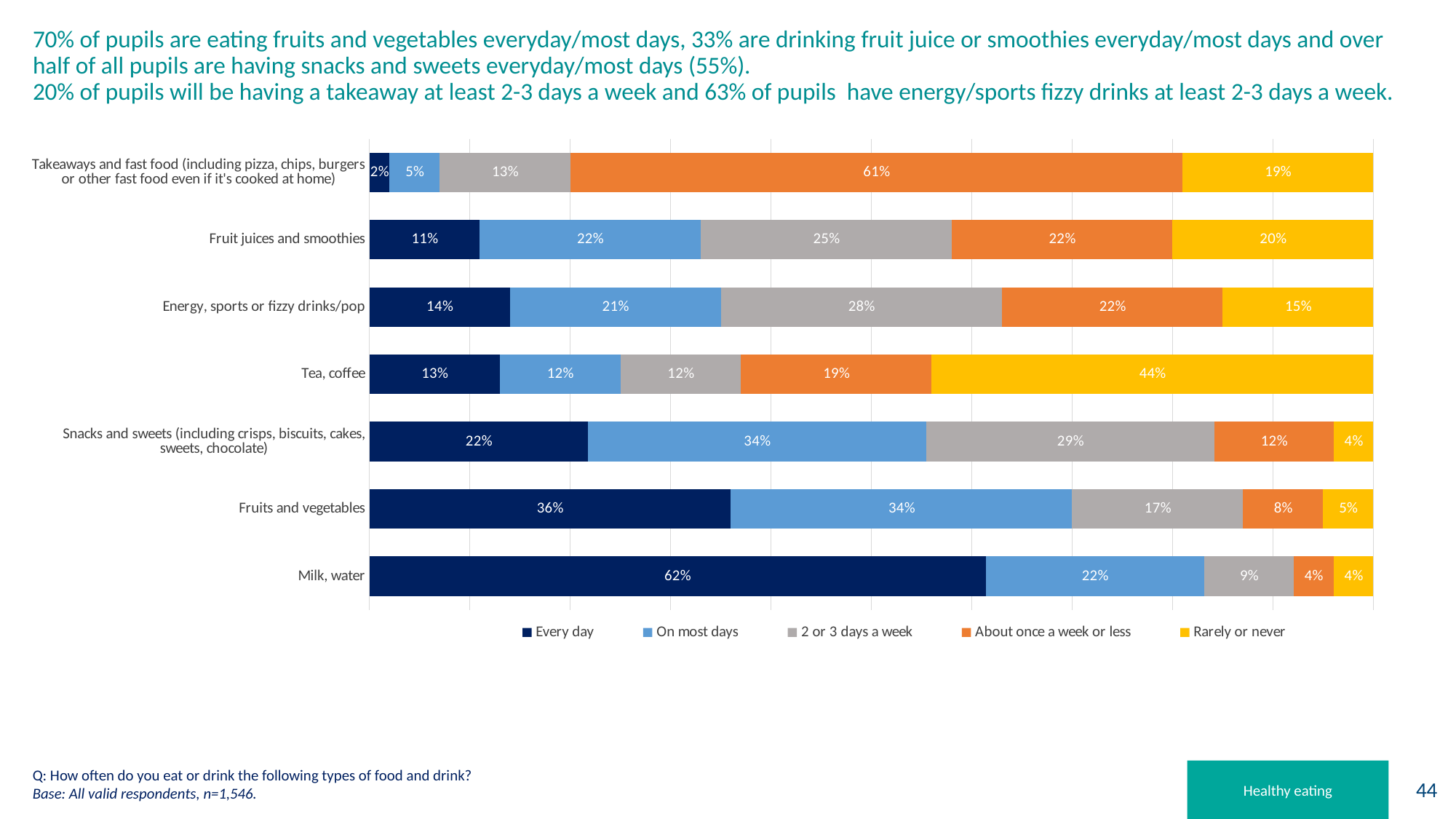
What percentage of pupils have milk or water every day? 62% Which is larger: the 'On most days' percentage for energy, sports or fizzy drinks/pop, or for tea, coffee? Energy, sports or fizzy drinks/pop What is the difference between the 'Every day' percentages for fruits and vegetables and for snacks and sweets? 14% What kind of chart is shown on the slide? Stacked bar chart Which food or drink category has the highest 'Every day' percentage? Milk, water What percentage of pupils have tea or coffee rarely or never? 44% What percentage of pupils have takeaways and fast food about once a week or less? 61% How many food and drink categories are shown in the chart? 7 How many series does the legend list? 5 What percentage of pupils have fruit juices and smoothies 2 or 3 days a week? 25% Which colour represents 'Rarely or never' in the chart? Yellow Which food or drink category has the lowest 'Every day' percentage? Takeaways and fast food (including pizza, chips, burgers or other fast food even if it's cooked at home)